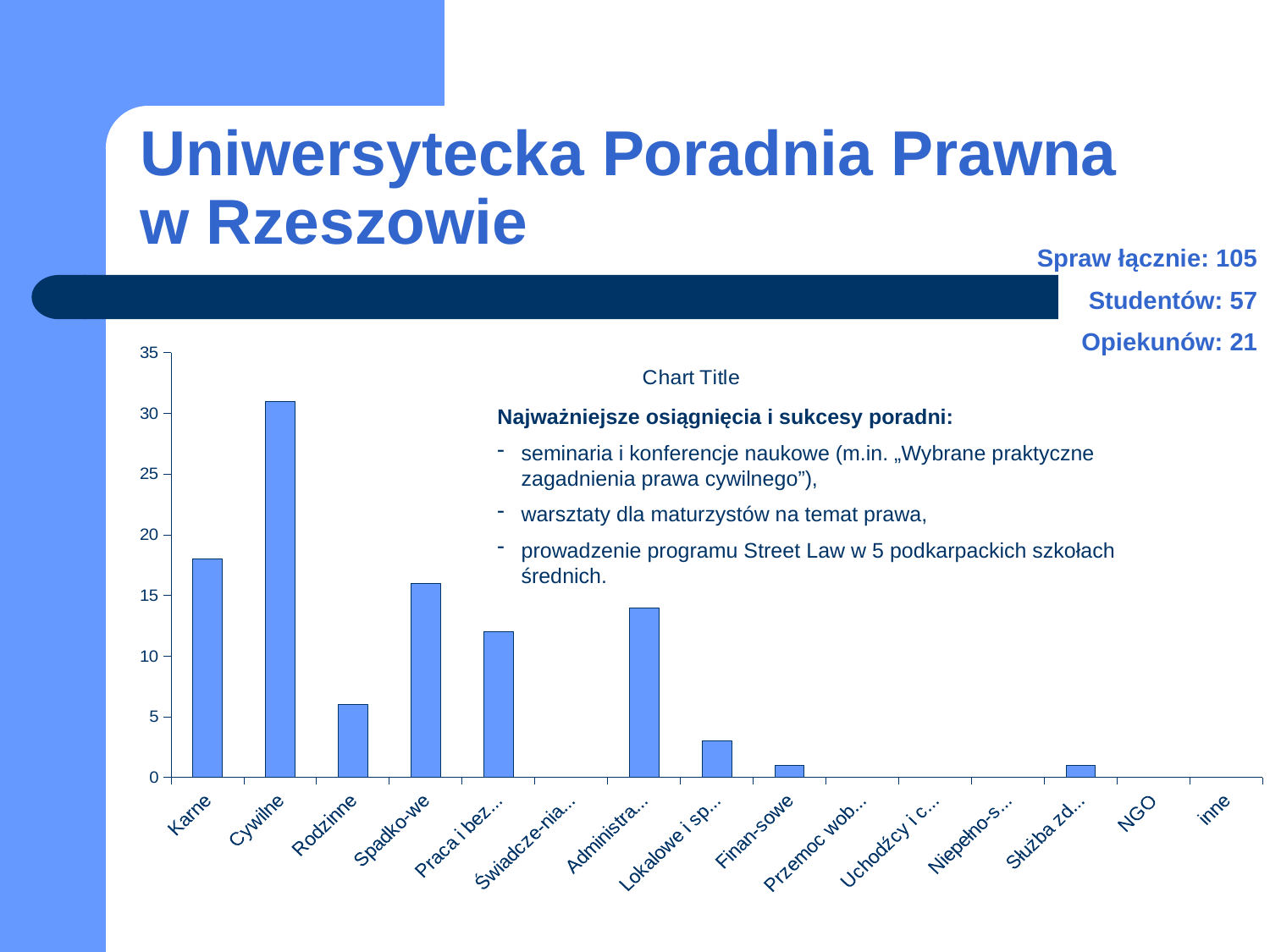
Which is larger, the value for Karne or the value for Administra...? Karne What kind of chart is shown on the slide? bar chart Is the value for Praca i bez... greater or less than 10? greater How many categories are shown on the x axis of the chart? 15 Is the value for Cywilne greater or less than 25? greater Which category has the highest bar in the chart? Cywilne Is the value for Karne greater or less than 20? less Which is larger, the value for Rodzinne or the value for Lokalowe i sp...? Rodzinne What is the title shown on the chart? Chart Title